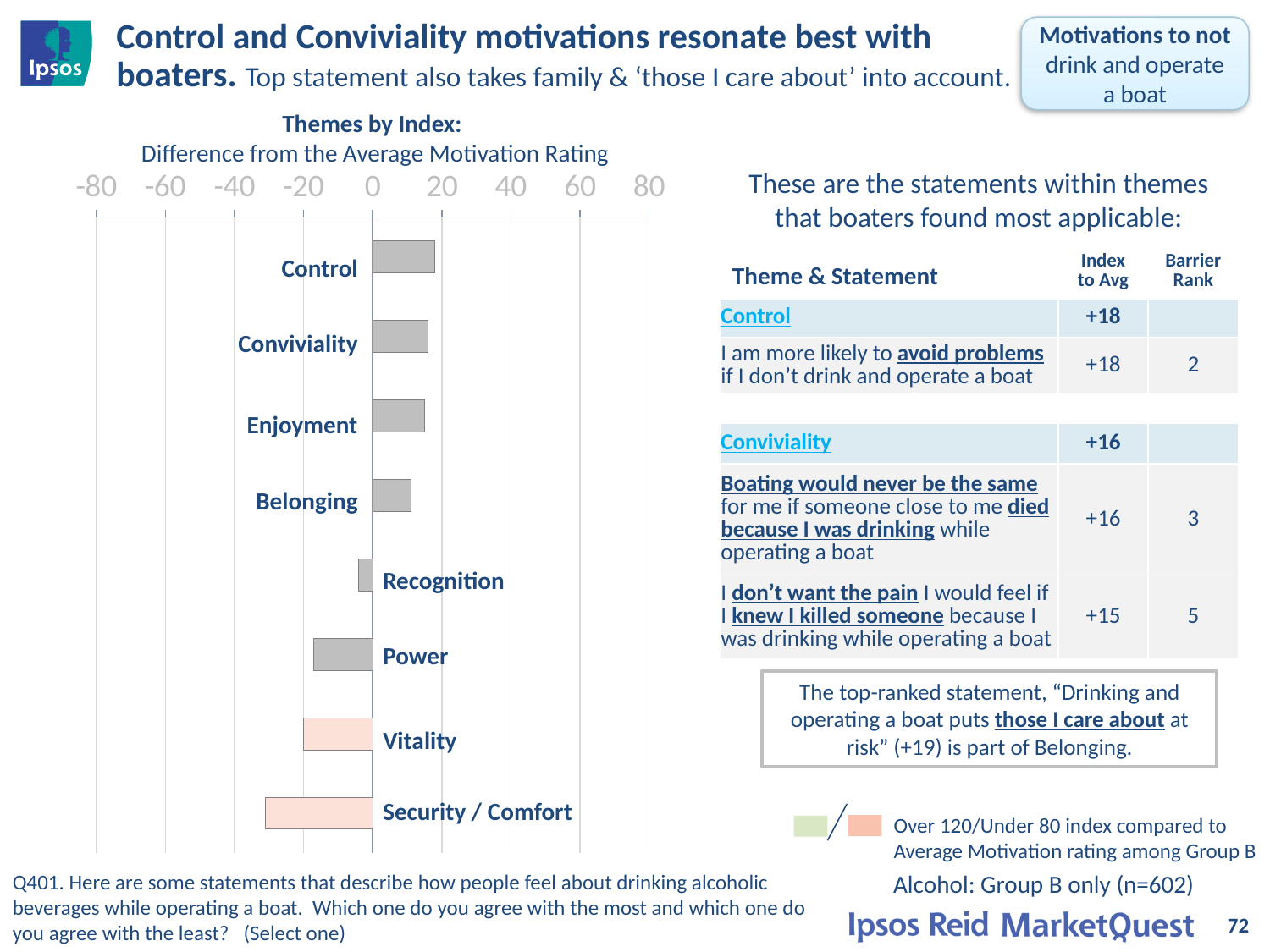
Which has the larger value in the bar chart, Belonging or Control? Control How many themes in the bar chart have a negative value? 4 How many themes are plotted in the bar chart? 8 Is the value for Security / Comfort greater or less than -20? less Which theme has the highest value in the bar chart? Control Which has the larger value in the bar chart, Vitality or Security / Comfort? Vitality Which theme has the lowest value in the bar chart? Security / Comfort What is the title of the bar chart? Themes by Index: Difference from the Average Motivation Rating What kind of chart is shown on the slide? Bar chart Is the value for Belonging greater or less than 20? less Is the value for Recognition greater or less than 0? less Which has the larger value in the bar chart, Control or Power? Control